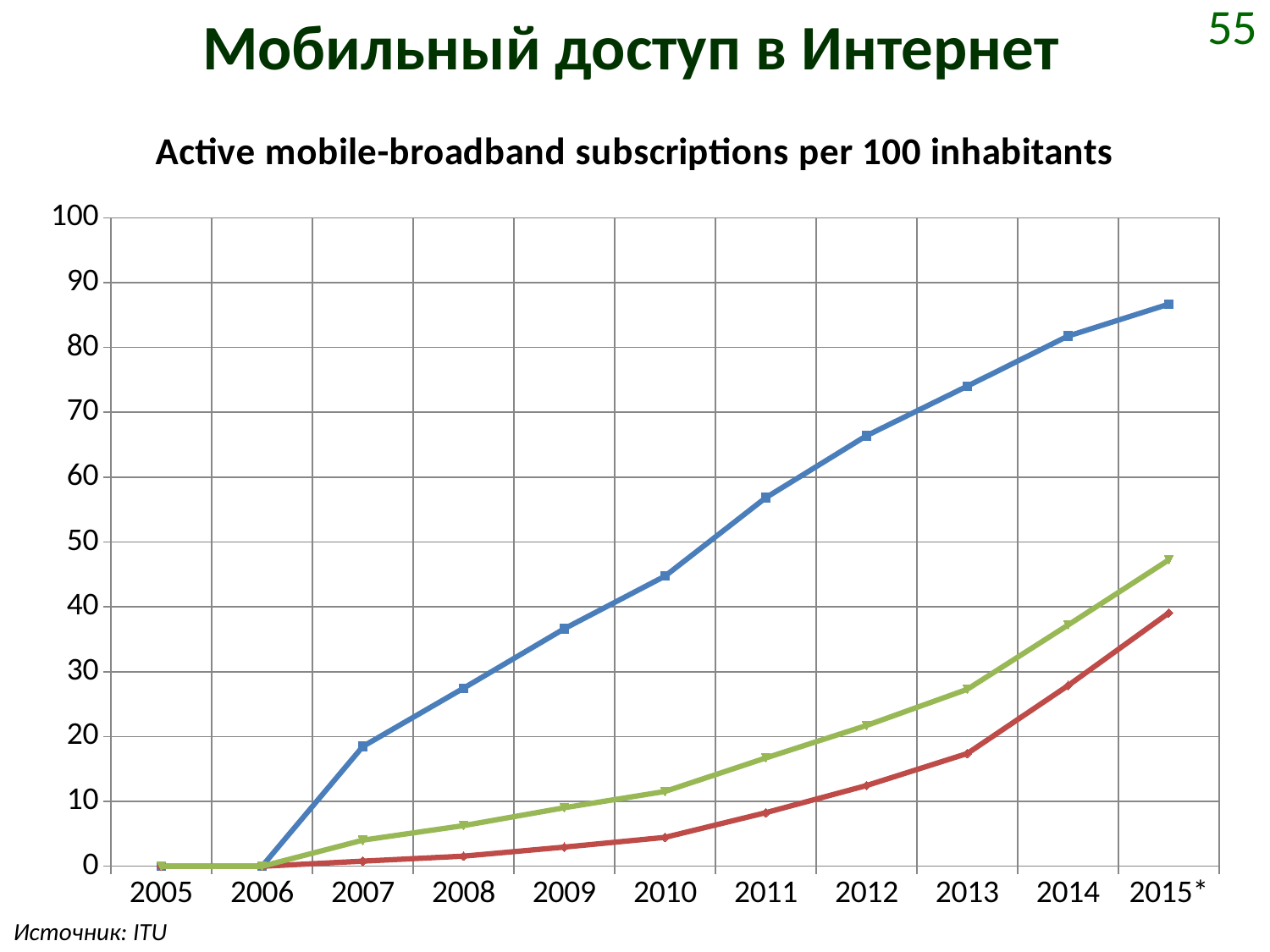
Is the value of the red line in 2013 greater or less than 20? less Is the value of the blue line in 2012 greater or less than 60? greater How many years are shown on the x axis of the chart? 11 How many lines are plotted on the chart? 3 In 2011, which is larger: the value of the green line or the value of the red line? green line What is the title of the chart? Active mobile-broadband subscriptions per 100 inhabitants What kind of chart is shown on the slide? line chart Which line has the highest value in 2015*: blue, green or red? blue Is the value of the green line in 2013 greater or less than 20? greater Does the blue line rise or fall from 2006 to 2015*? rise Which line has the lowest value in 2014: blue, green or red? red